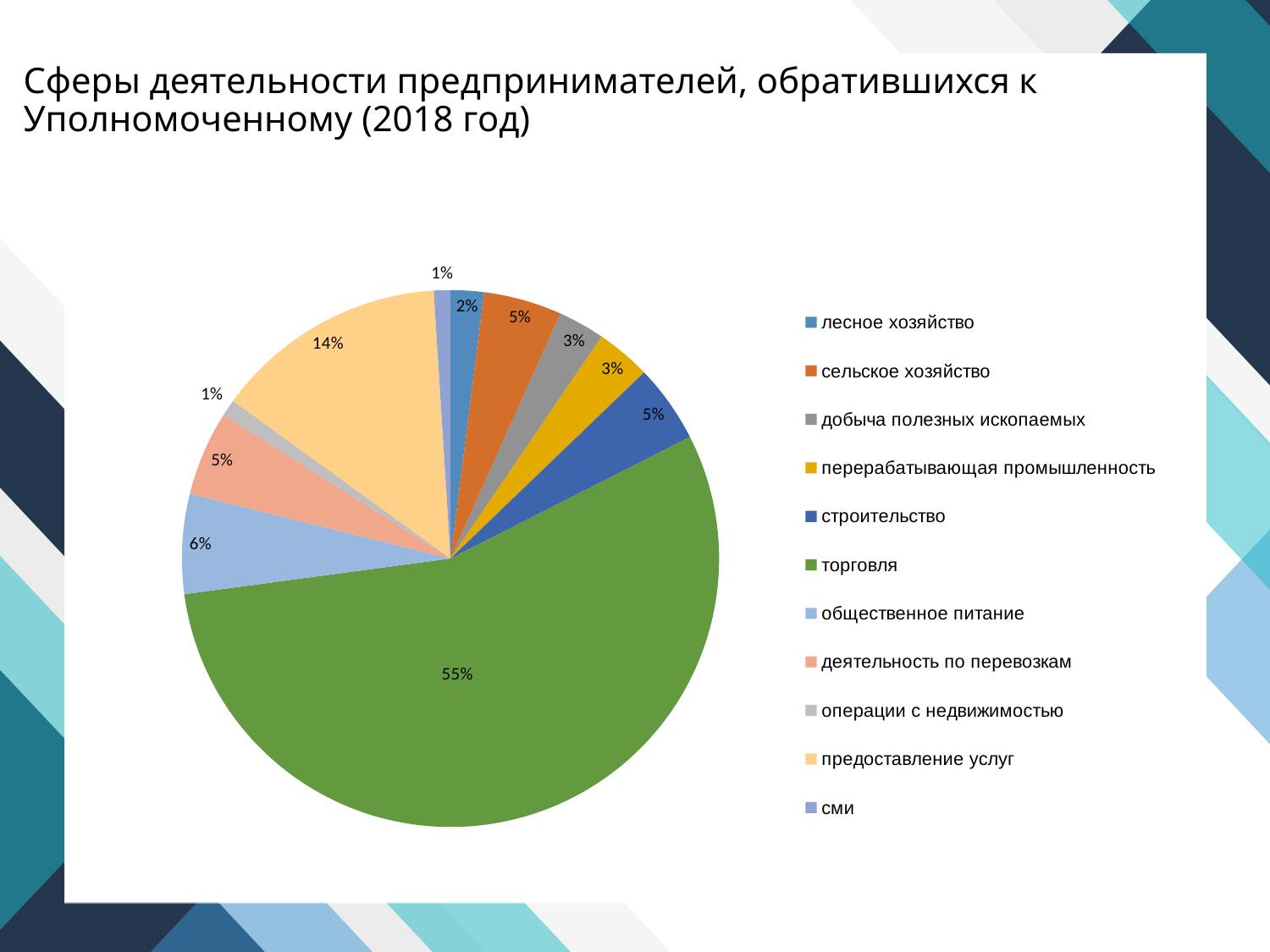
What share of the pie does торговля account for? 55% What type of chart is shown on the slide? pie chart How many categories does the legend list? 11 What is the value shown for предоставление услуг? 14% Which is larger, the share for общественное питание or the share for строительство? общественное питание What is the difference between the shares of торговля and предоставление услуг? 41% What is the value shown for общественное питание? 6% What is the value shown for лесное хозяйство? 2% What is the difference between the shares of предоставление услуг and общественное питание? 8% What is the value shown for сми? 1% Which category has the largest slice of the pie? торговля What colour is the slice for торговля? green